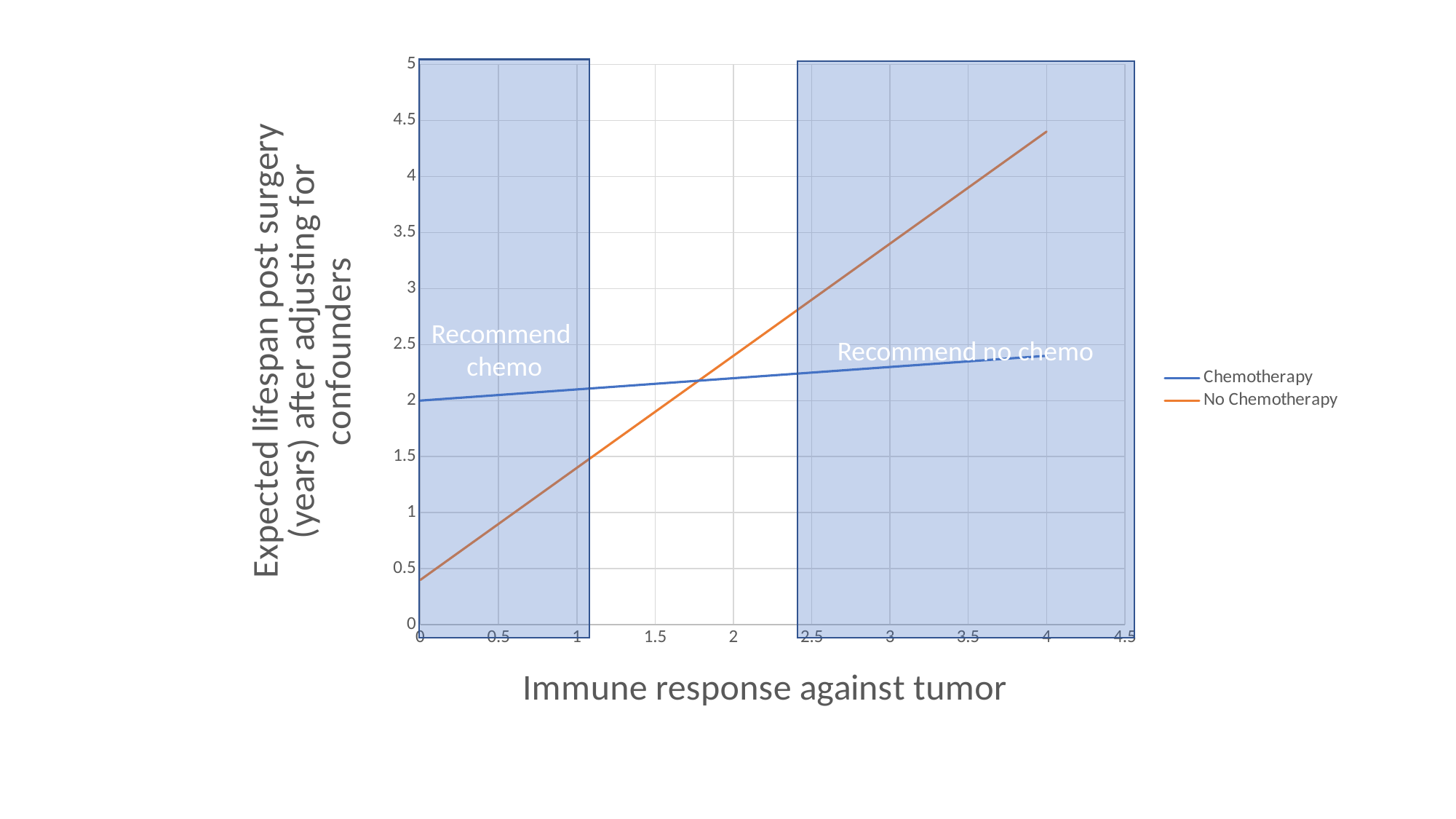
Is the Chemotherapy value at an immune response of 0 greater or less than 2.5? less What are the two series named in the legend? Chemotherapy and No Chemotherapy What is the title of the x axis? Immune response against tumor Is the No Chemotherapy value at an immune response of 4 greater or less than 4? greater At an immune response of 4, which series has the higher expected lifespan? No Chemotherapy How many series does the legend list? 2 At an immune response of 0, which series has the higher expected lifespan? Chemotherapy Is the No Chemotherapy value at an immune response of 0 greater or less than 1? less Which series rises more steeply across the x axis, Chemotherapy or No Chemotherapy? No Chemotherapy Does the Chemotherapy line rise or fall as immune response increases? Rises What kind of chart is shown on the slide? Line chart Does the No Chemotherapy line rise or fall as immune response increases? Rises